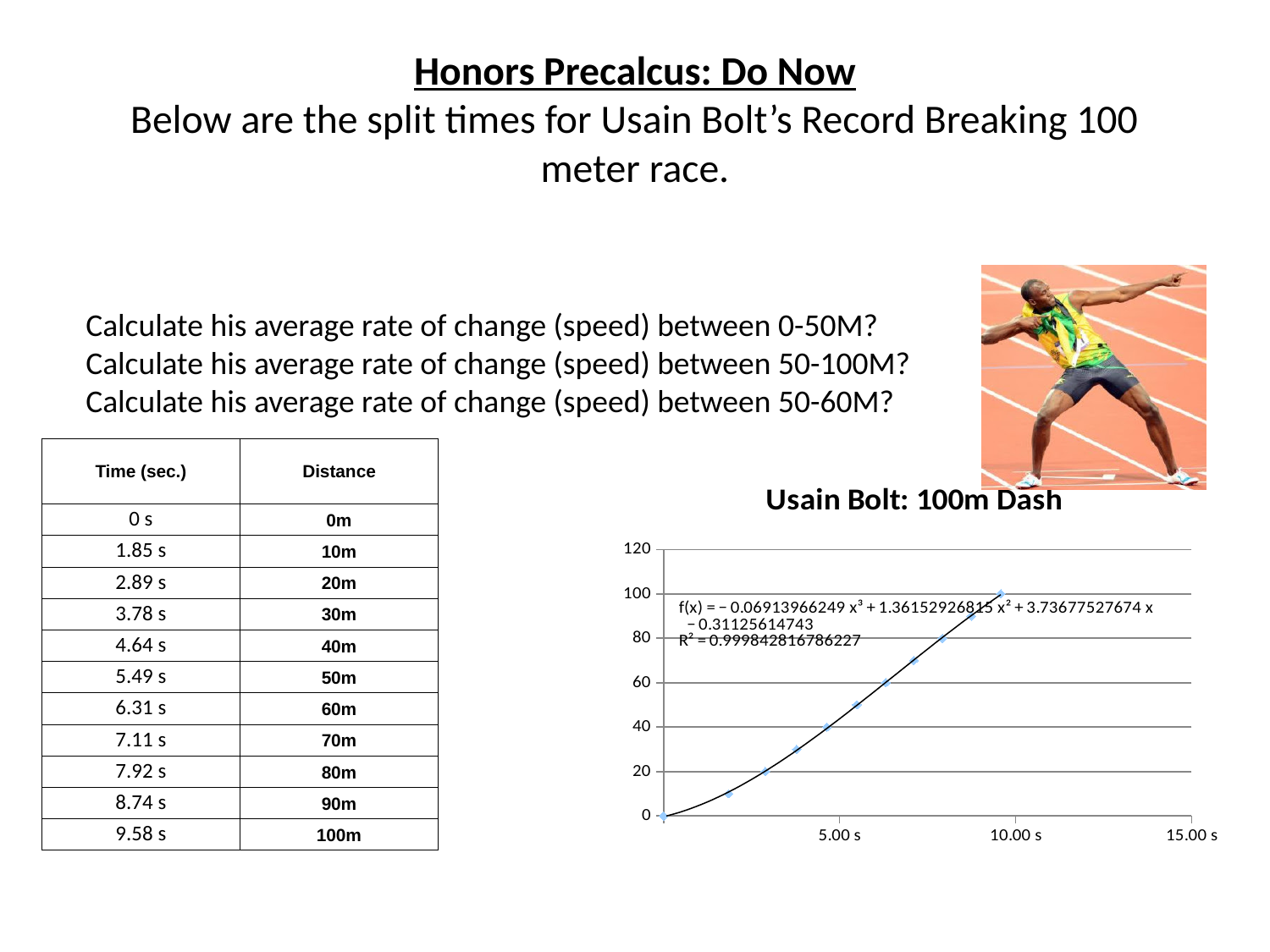
What is the highest distance value plotted on the chart? 100 Is the time of the last plotted point greater or less than 10.00 s? less Is the distance of the second plotted point (just after the start) greater or less than 20? less What kind of chart is shown on the slide? scatter chart with a trendline Which is larger: the distance of the first plotted point or the distance of the last plotted point? the last plotted point How many data points are plotted on the chart? 11 What is the title of the chart? Usain Bolt: 100m Dash What is the lowest distance value plotted on the chart? 0 Is the distance of the last plotted point greater or less than 80? greater What R² value is printed on the chart? 0.999842816786227 Do the plotted values rise or fall as time increases along the x axis? rise